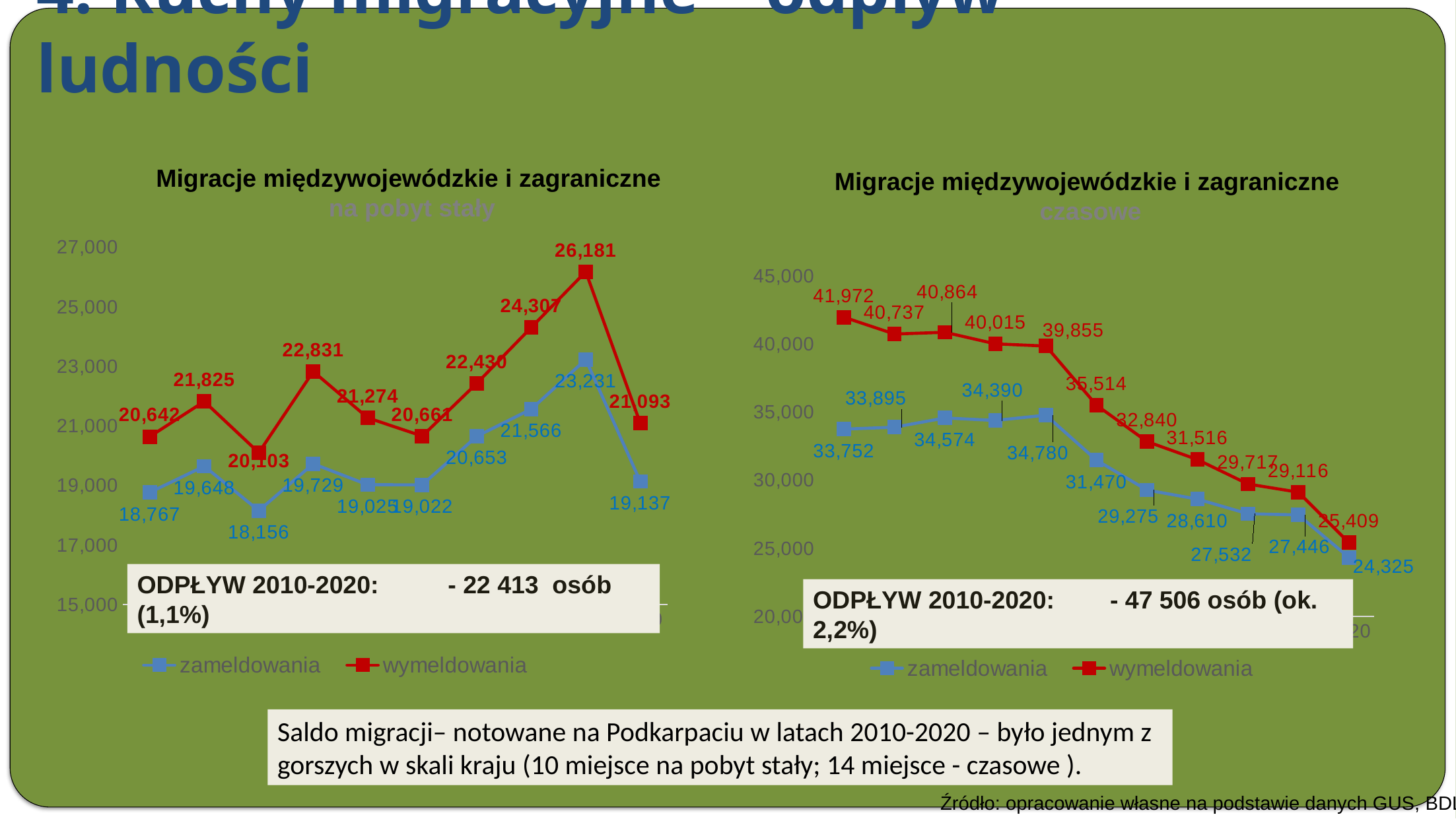
In the right chart (czasowe), what is the lowest value of the zameldowania series? 24,325 In the right chart (czasowe), what is the highest value of the wymeldowania series? 41,972 In the left chart (na pobyt stały), what is the difference between the highest wymeldowania value (26,181) and the highest zameldowania value (23,231)? 2,950 In the right chart (czasowe), does the wymeldowania series generally rise or fall along the x axis? fall In the right chart (czasowe), what is the last plotted value of the wymeldowania series? 25,409 In the left chart (na pobyt stały), what is the lowest value of the wymeldowania series? 20,103 In the left chart (na pobyt stały), what is the highest value of the wymeldowania series? 26,181 How many series does the legend of the left chart (na pobyt stały) list? 2 What type of chart is used on the slide for the migration data? line chart In the left chart (na pobyt stały), what is the lowest value of the zameldowania series? 18,156 In the right chart (czasowe), what is the difference between the first wymeldowania value (41,972) and the last wymeldowania value (25,409)? 16,563 In the right chart (czasowe), which series has higher values throughout, zameldowania or wymeldowania? wymeldowania